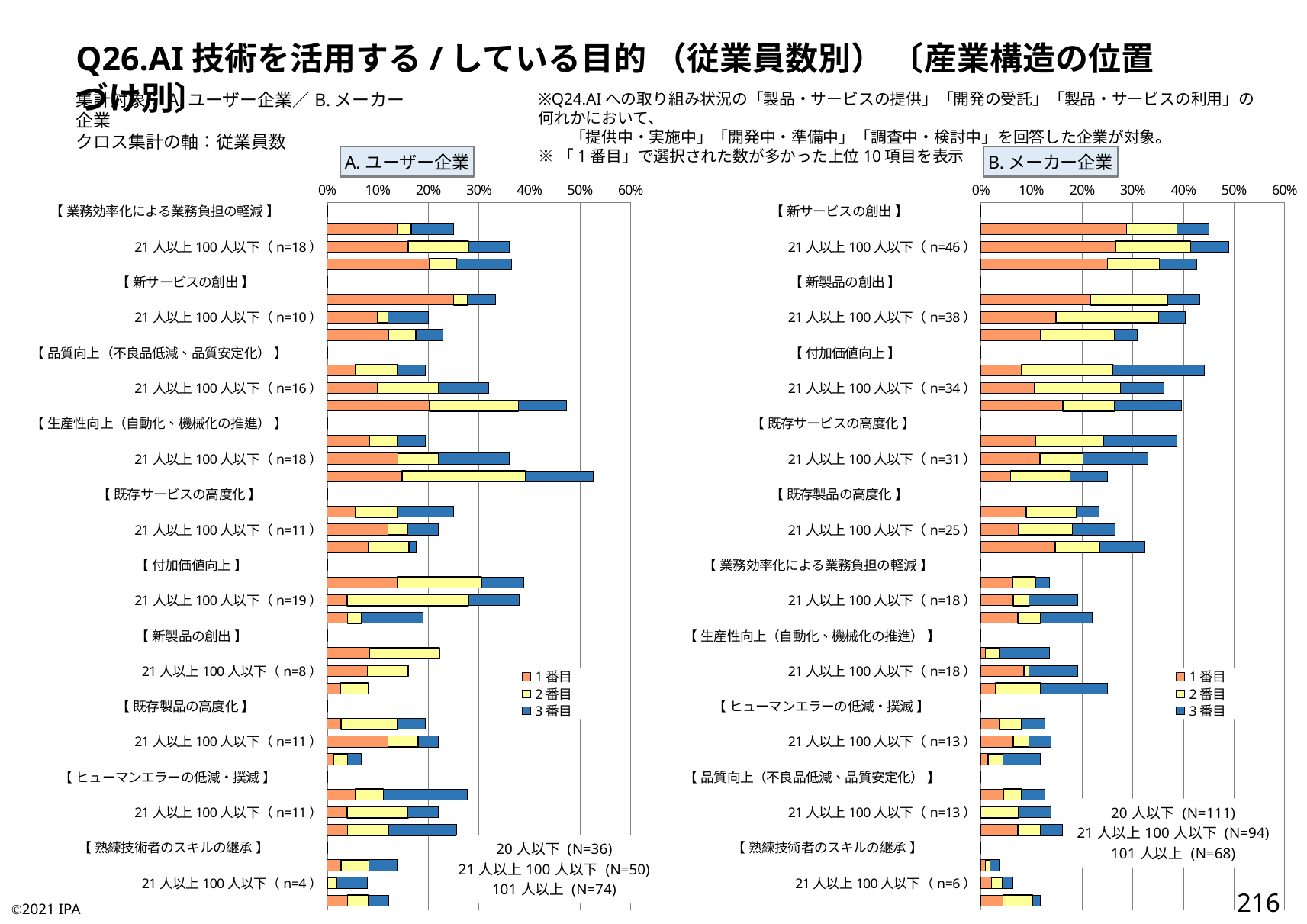
What is the maximum value shown on the horizontal axis of the right chart (B. メーカー企業)? 60% What are the legend entries of the left chart (A. ユーザー企業)? 1番目, 2番目, 3番目 In the right chart (B. メーカー企業), is the total of the second bar (21人以上100人以下, n=46) under 【新サービスの創出】 greater or less than 40%? greater How many series does the legend of the right chart (B. メーカー企業) list? 3 What kind of chart is the left chart titled A. ユーザー企業? Stacked horizontal bar chart In the left chart (A. ユーザー企業), how many bars are drawn for each purpose category? 3 In the left chart (A. ユーザー企業), which purpose category contains the longest stacked bar? 【生産性向上（自動化、機械化の推進）】 In the right chart (B. メーカー企業), which is larger: the total of the 20人以下 bar under 【付加価値向上】 or the total of the 20人以下 bar under 【品質向上（不良品低減、品質安定化）】? 【付加価値向上】 In the left chart (A. ユーザー企業), is the total of the first bar (20人以下) under 【新サービスの創出】 greater or less than 30%? greater How many purpose categories (bracketed items) are shown in the right chart (B. メーカー企業)? 10 In the right chart (B. メーカー企業), is the total of the first bar (20人以下) under 【熟練技術者のスキルの継承】 greater or less than 10%? less